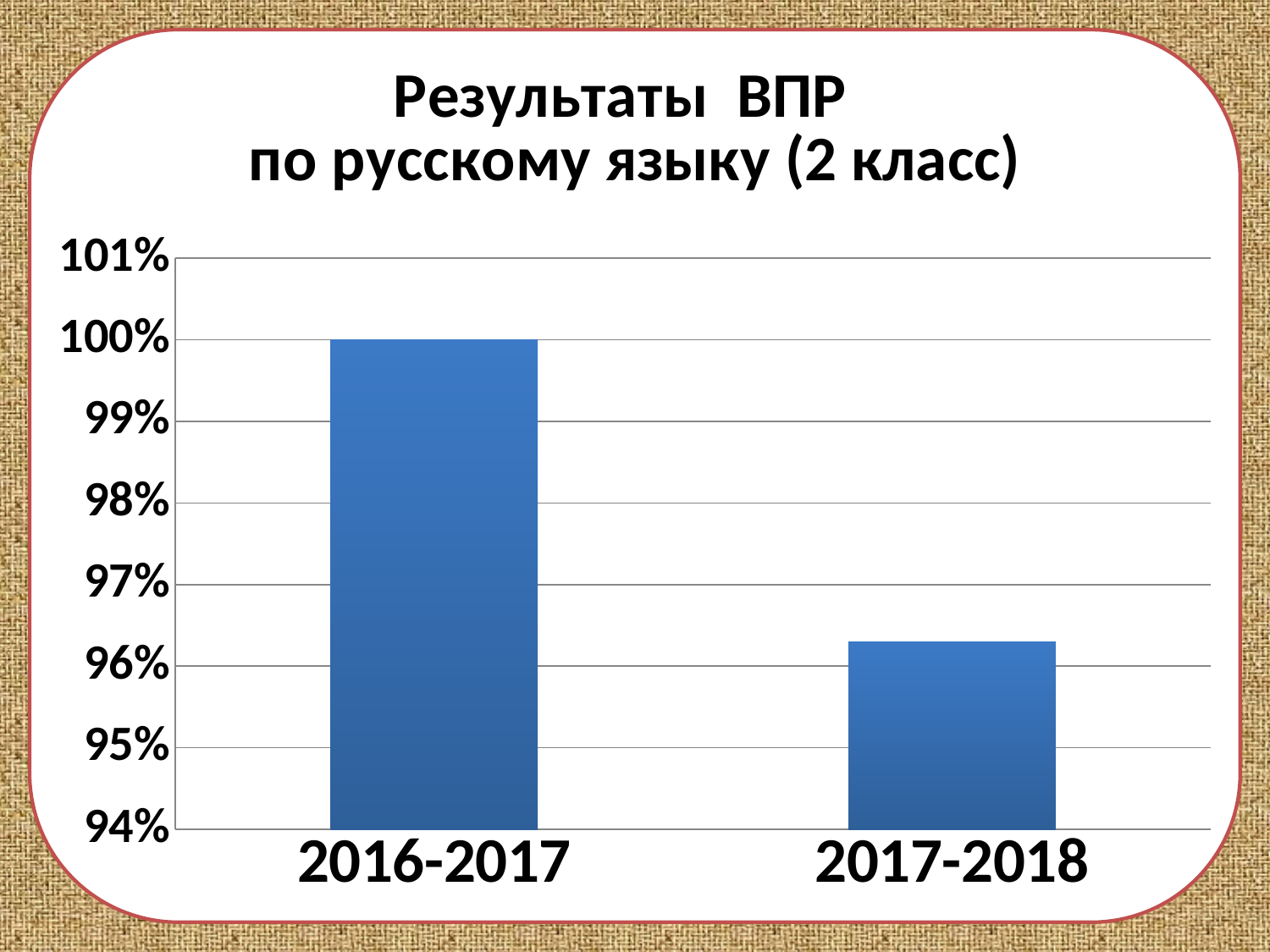
What is the title of the chart? Результаты ВПР по русскому языку (2 класс) What is the highest value labelled on the y axis? 101% What is the value for 2016-2017? 100% Which is larger, the value for 2016-2017 or the value for 2017-2018? 2016-2017 How many categories are shown on the x axis? 2 Is the value for 2017-2018 greater or less than 97%? less Which category has the highest value? 2016-2017 Is the value for 2017-2018 greater or less than 96%? greater What kind of chart is shown on the slide? bar chart Do the values rise or fall from 2016-2017 to 2017-2018? fall Which category has the lowest value? 2017-2018